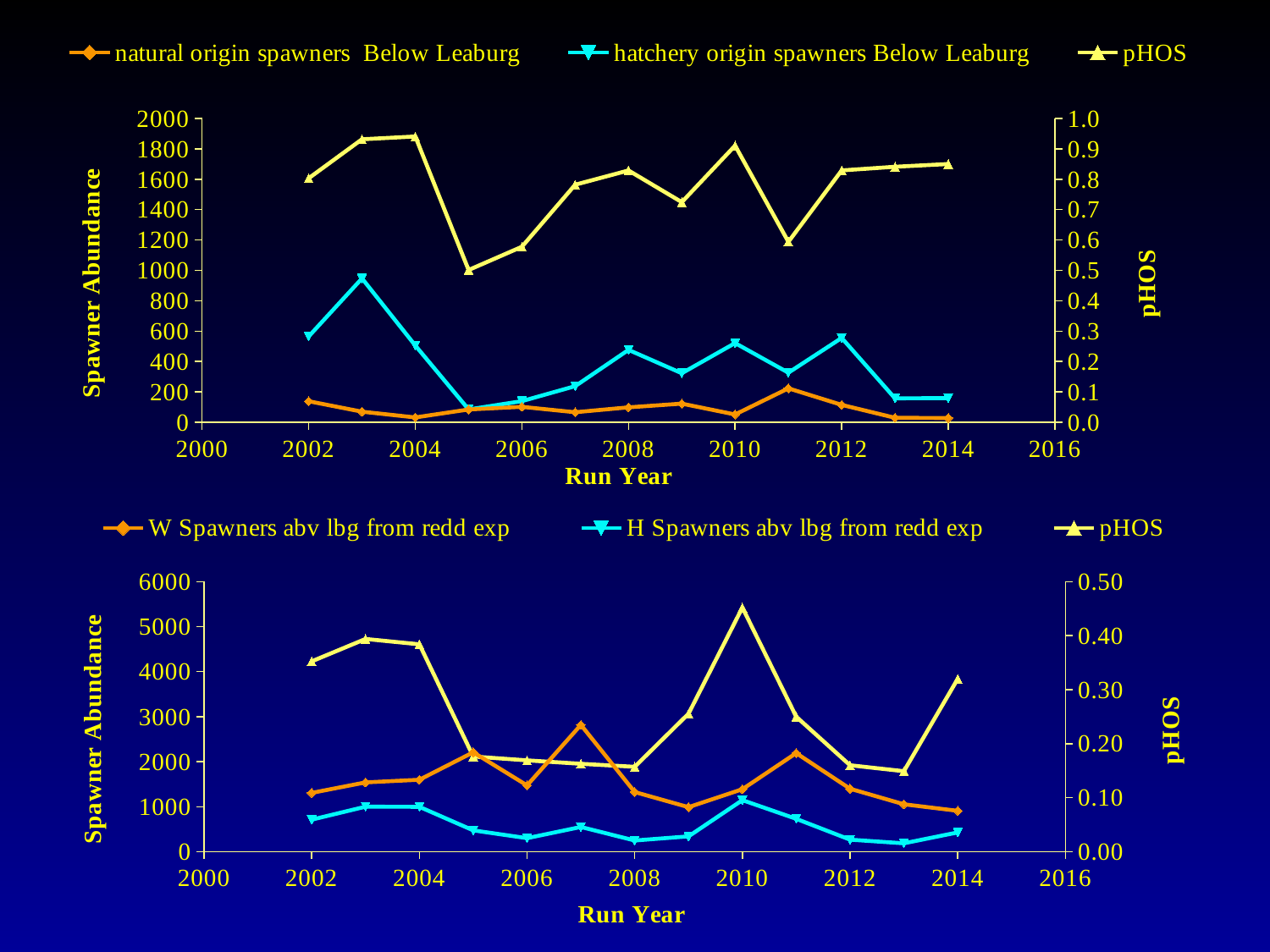
How many series does the legend of the top chart list? 3 In the top chart, in which run year is the hatchery origin spawners Below Leaburg series highest? 2003 In the top chart, in which run year is the natural origin spawners Below Leaburg series highest? 2011 In the bottom chart, in which run year is the W Spawners abv lbg from redd exp series highest? 2007 In the top chart, which is larger in 2003: natural origin spawners Below Leaburg or hatchery origin spawners Below Leaburg? hatchery origin spawners Below Leaburg In the bottom chart, is the pHOS value in 2010 greater or less than 0.40? greater What kind of chart is the top chart on the slide? line chart How many series does the legend of the bottom chart list? 3 In the top chart, is the value for hatchery origin spawners Below Leaburg in 2003 greater or less than 800? greater In the bottom chart, is the value for W Spawners abv lbg from redd exp in 2007 greater or less than 2000? greater In the top chart, in which run year is pHOS lowest? 2005